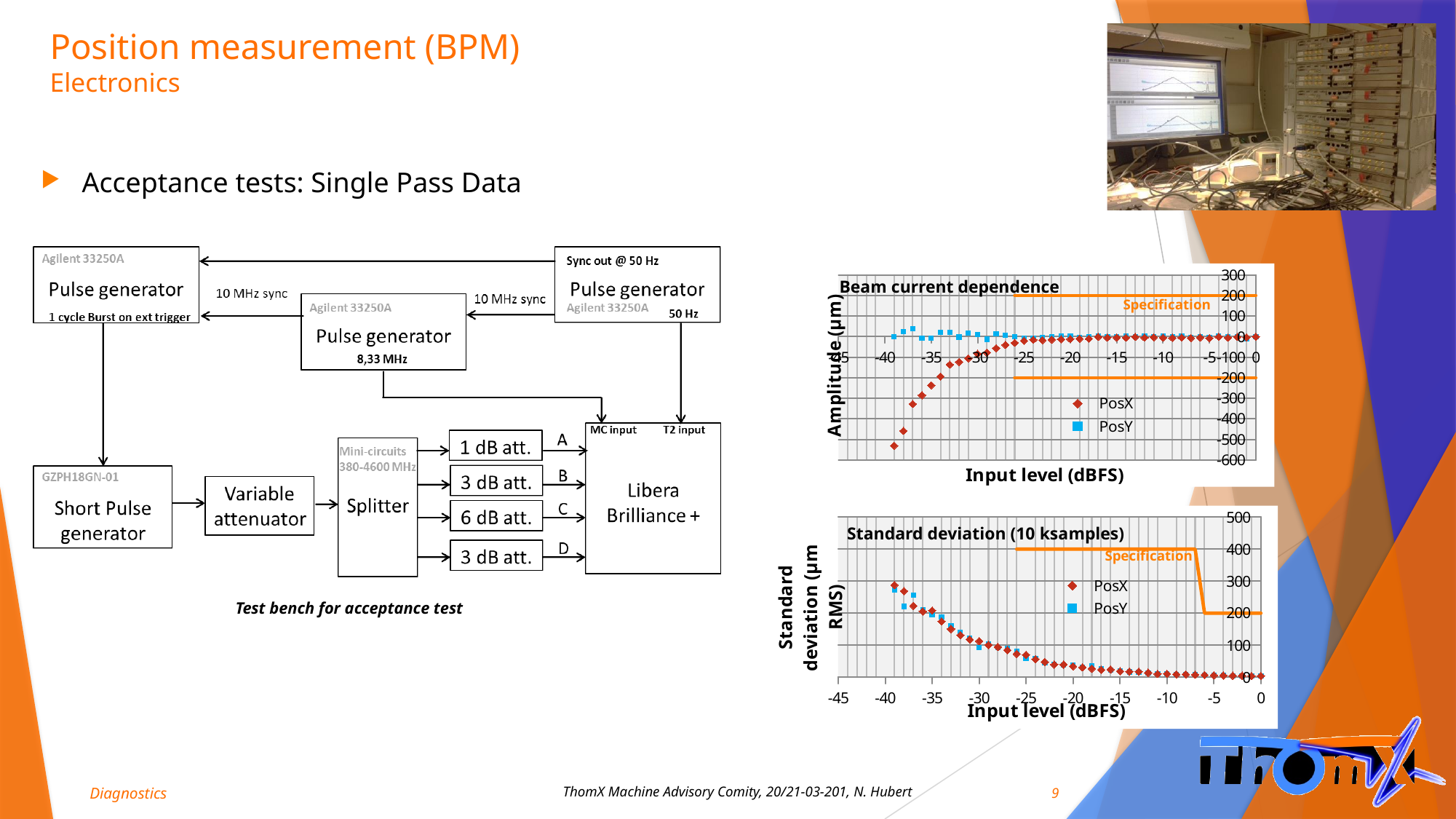
In the 'Standard deviation (10 ksamples)' chart, do the values rise or fall as the input level increases along the x axis? fall In the 'Beam current dependence' chart, is the PosX value at -40 dBFS greater or less than -400? less In the 'Beam current dependence' chart, which series has the lower value at -40 dBFS, PosX or PosY? PosX In the 'Beam current dependence' chart, do the PosX values rise or fall as the input level increases from -40 dBFS toward -25 dBFS? rise In the 'Standard deviation (10 ksamples)' chart, is the PosX value at 0 dBFS greater or less than 100? less In the 'Beam current dependence' chart, is the PosY value at -40 dBFS greater or less than -100? greater In the 'Beam current dependence' chart, what are the two series named in the legend? PosX and PosY What kind of chart is the 'Standard deviation (10 ksamples)' chart? scatter chart In the 'Beam current dependence' chart, how many series does the legend list? 2 What is the x-axis title of the 'Beam current dependence' chart? Input level (dBFS) In the 'Standard deviation (10 ksamples)' chart, how many series does the legend list? 2